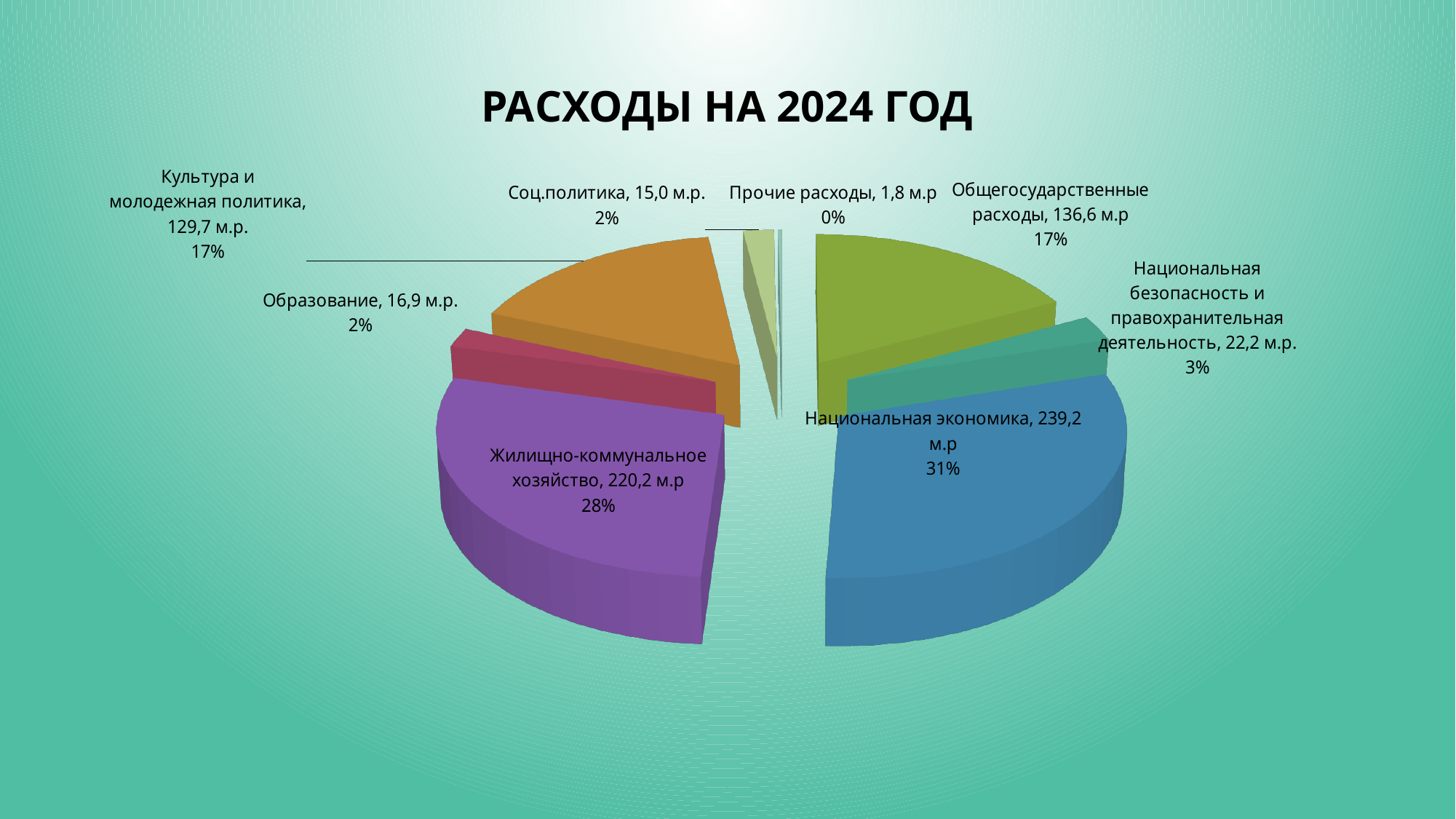
Which category has the largest share of the pie? Национальная экономика How many slices does the pie chart have? 8 What kind of chart is shown on the slide? Pie chart What is the title of the chart? РАСХОДЫ НА 2024 ГОД What is the value for Национальная экономика? 239,2 м.р What is the value for Национальная безопасность и правохранительная деятельность? 22,2 м.р. What is the difference between the values for Национальная экономика and Жилищно-коммунальное хозяйство? 19,0 м.р What is the value for Жилищно-коммунальное хозяйство? 220,2 м.р Which category has the smallest share of the pie? Прочие расходы What is the value for Культура и молодежная политика? 129,7 м.р. What share of the pie does Жилищно-коммунальное хозяйство represent? 28% Which is larger, the value for Общегосударственные расходы or the value for Культура и молодежная политика? Общегосударственные расходы